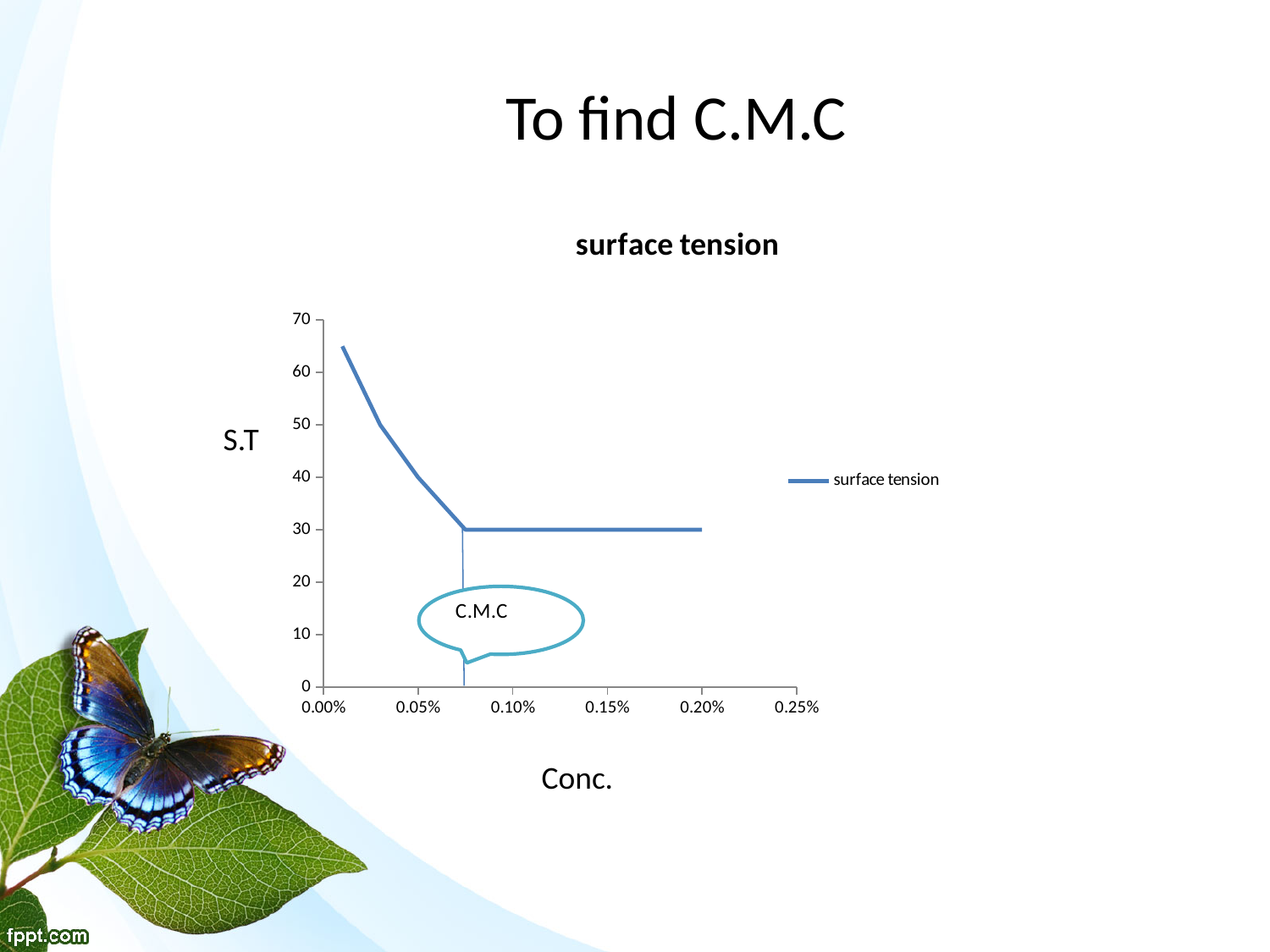
How many series does the legend list? 1 Is the surface tension value at 0.05% concentration greater or less than 50? less Does the surface tension rise or fall as concentration increases from 0.00% to 0.05%? fall Is the surface tension value at 0.10% concentration greater or less than 40? less Is the surface tension value at 0.15% concentration greater or less than 40? less What is the title of the chart? surface tension What kind of chart is shown on the slide? line chart Does the surface tension rise, fall or stay flat between 0.10% and 0.20% concentration? stay flat What is the surface tension value at 0.20% concentration? 30 What is the name of the series shown in the legend? surface tension Is the surface tension at 0.05% concentration larger or smaller than at 0.15% concentration? larger